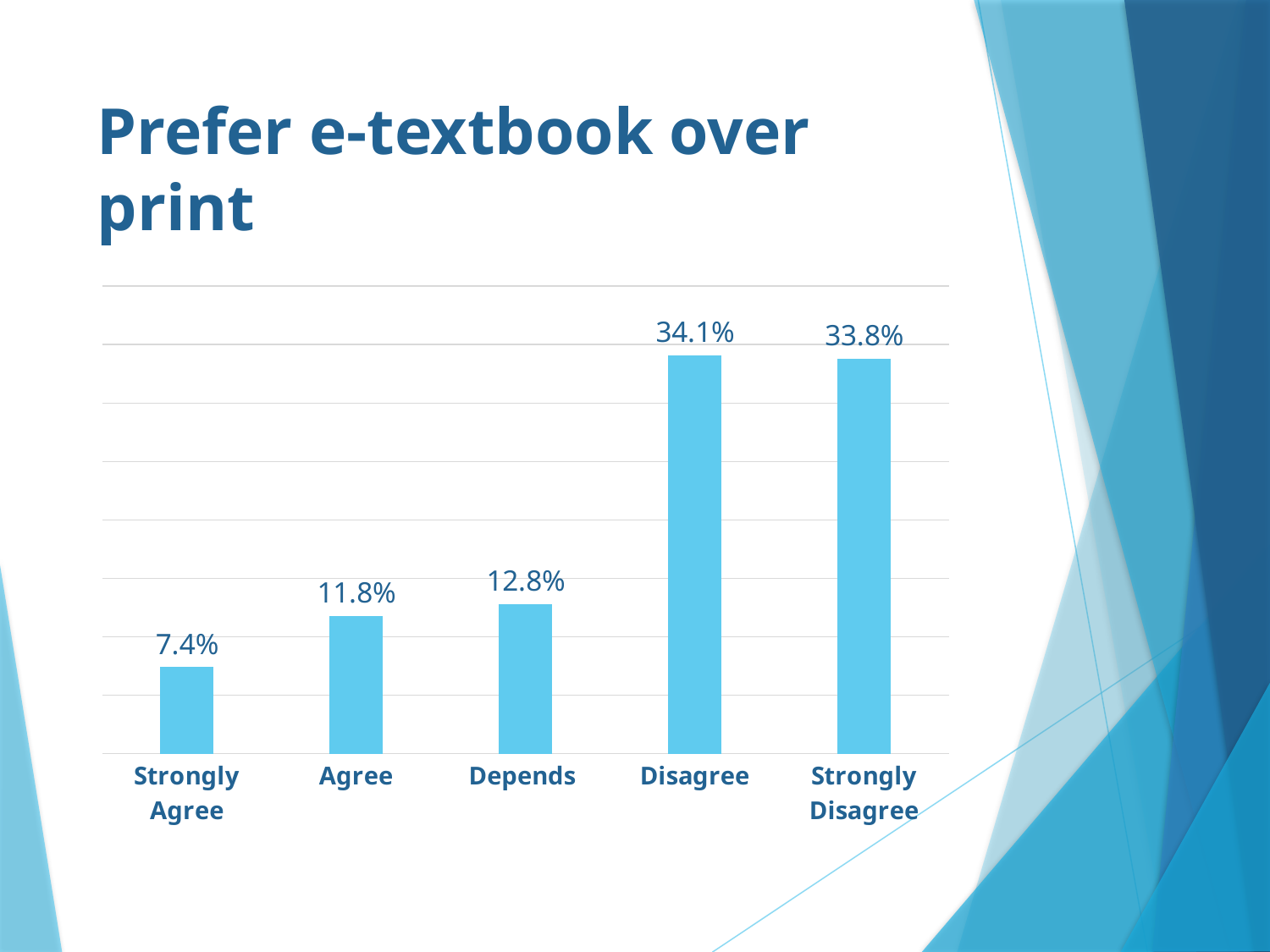
What is the difference between the values for Disagree and Strongly Agree? 26.7% What is the value for Agree? 11.8% Which category has the highest value? Disagree What is the value for Depends? 12.8% What kind of chart is shown on the slide? Bar chart What is the value for Strongly Disagree? 33.8% What is the difference between the values for Depends and Agree? 1.0% Which category has the lowest value? Strongly Agree How many categories are shown in the chart? 5 What is the value for Strongly Agree? 7.4% What is the value for Disagree? 34.1% Which is larger, the value for Agree or the value for Depends? Depends